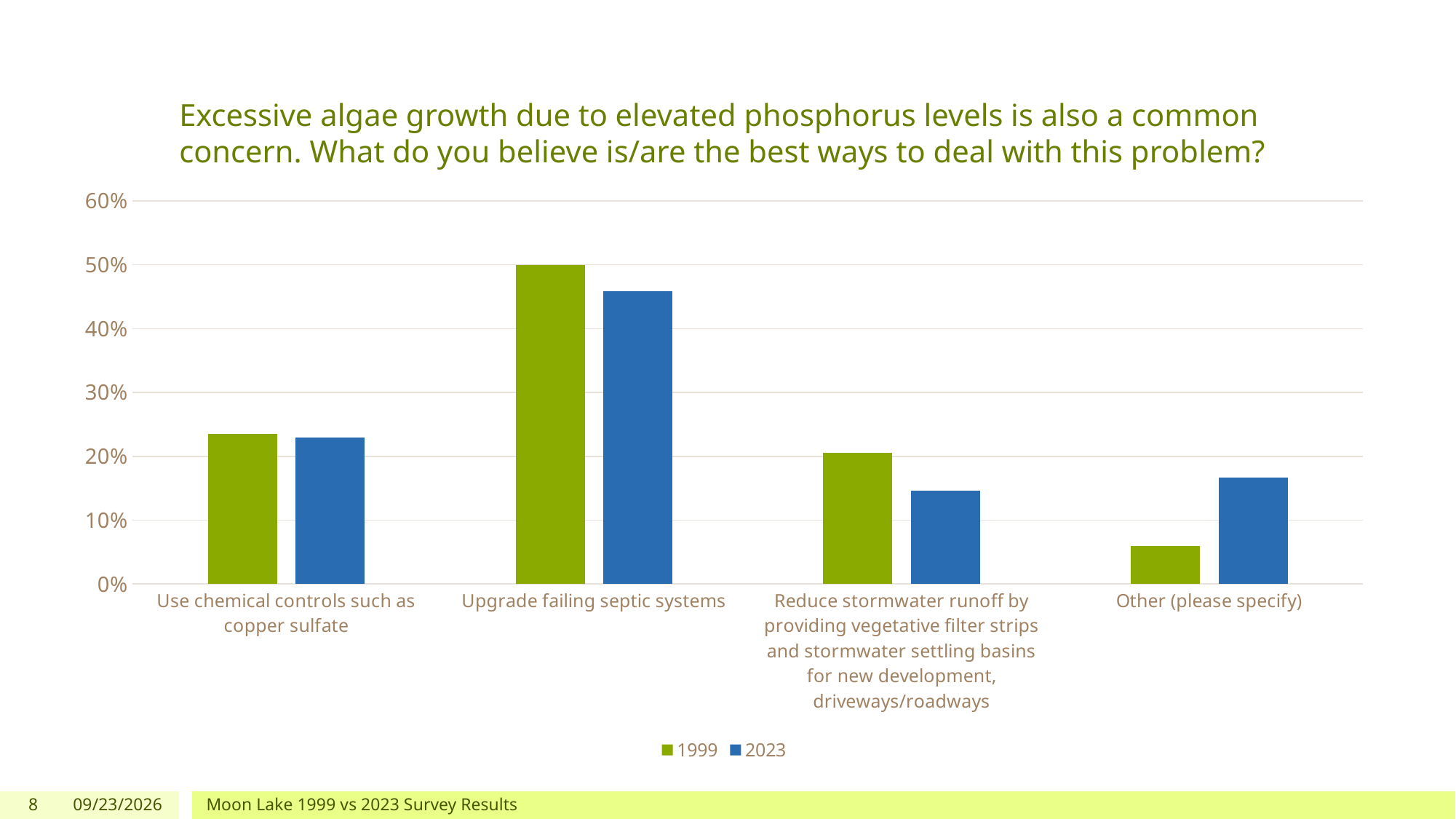
For "Reduce stormwater runoff by providing vegetative filter strips and stormwater settling basins for new development, driveways/roadways", which year has the larger value, 1999 or 2023? 1999 What kind of chart is shown on the slide? bar chart How many categories are shown on the x axis? 4 Which colour represents the 2023 series in the legend? blue Is the 2023 value for "Upgrade failing septic systems" greater or less than 40%? greater How many series does the legend list? 2 Is the 1999 value for "Other (please specify)" greater or less than 10%? less Which category has the highest 1999 value? Upgrade failing septic systems Is the 2023 value for "Other (please specify)" greater or less than 10%? greater What is the 1999 value for "Upgrade failing septic systems"? 50% Which category has the lowest 1999 value? Other (please specify) Which category has the highest 2023 value? Upgrade failing septic systems